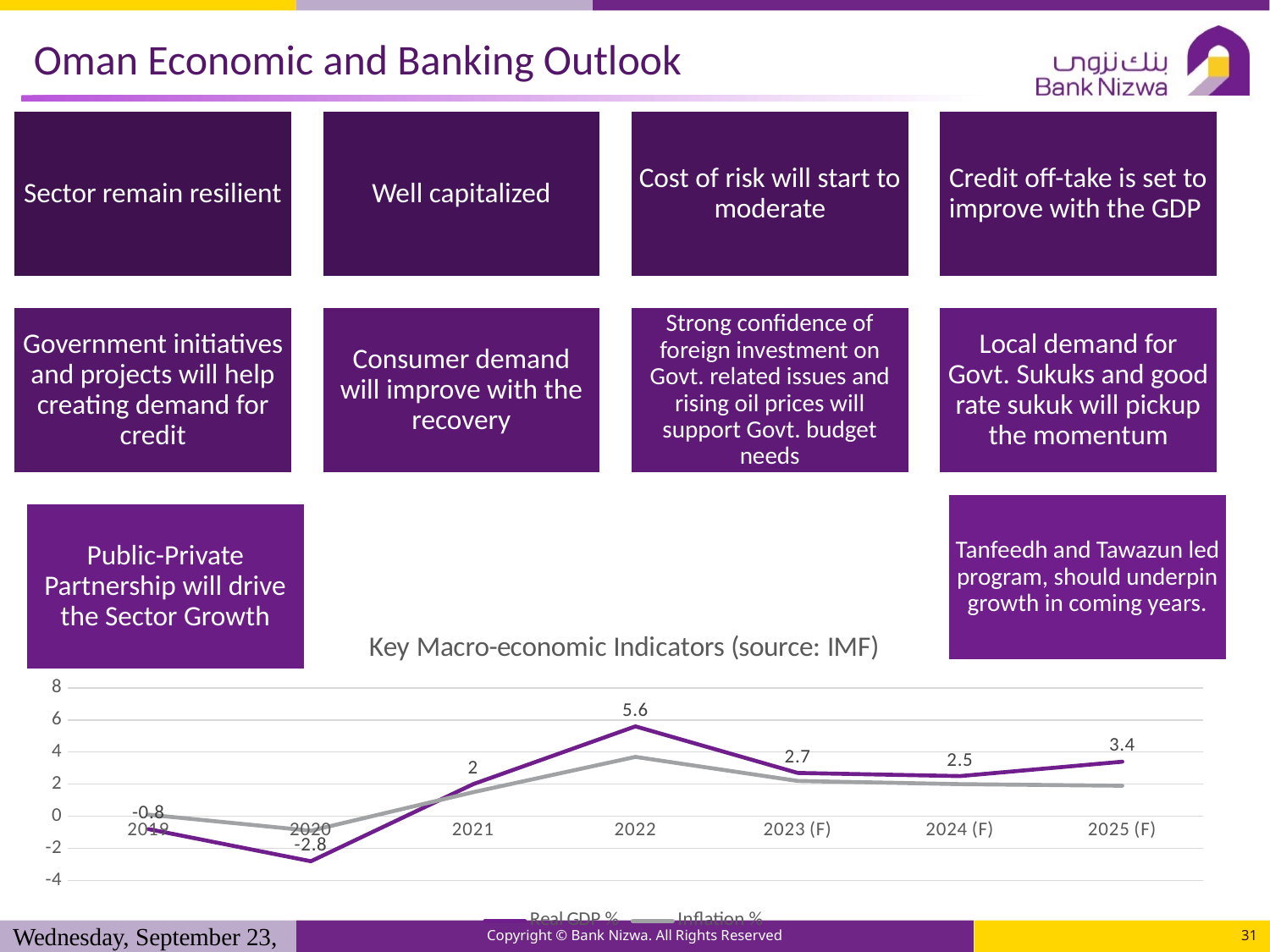
What is the Real GDP % value for 2020? -2.8 In which year is Real GDP % lowest? 2020 In which year is Real GDP % highest? 2022 Which year has the larger Real GDP % value, 2024 (F) or 2025 (F)? 2025 (F) How many series does the legend of the Key Macro-economic Indicators chart list? 2 Does Real GDP % rise or fall from 2020 to 2022? rise What kind of chart is the Key Macro-economic Indicators chart? line chart What is the Real GDP % value for 2022? 5.6 What is the difference between the Real GDP % values for 2022 and 2023 (F)? 2.9 What is the Real GDP % value for 2025 (F)? 3.4 Is the Inflation % value for 2022 greater or less than 2? greater How many years are plotted on the x axis of the Key Macro-economic Indicators chart? 7